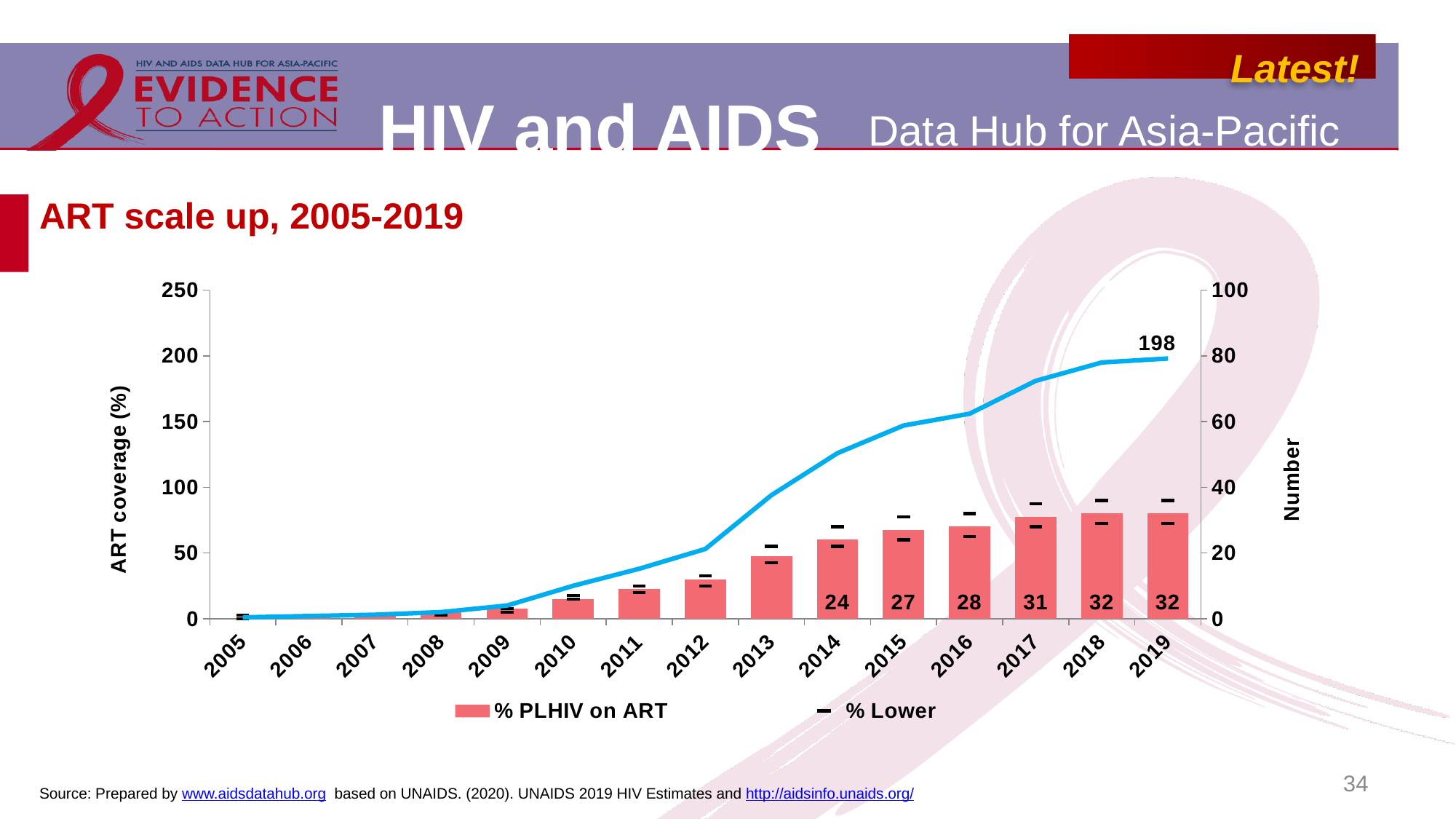
Which year has the lowest % PLHIV on ART bar? 2005 How many entries does the legend list? 2 What is the title of the chart? ART scale up, 2005-2019 What is the difference between the % PLHIV on ART values for 2017 and 2014? 7 How many years are shown on the x axis? 15 What is the difference between the % PLHIV on ART values for 2019 and 2014? 8 Which year has the larger % PLHIV on ART bar, 2015 or 2016? 2016 What value is labelled on the line at 2019? 198 What is the value of the % PLHIV on ART bar for 2017? 31 Do the % PLHIV on ART bars rise or fall from 2005 to 2019? rise What is the value of the % PLHIV on ART bar for 2019? 32 What is the value of the % PLHIV on ART bar for 2014? 24